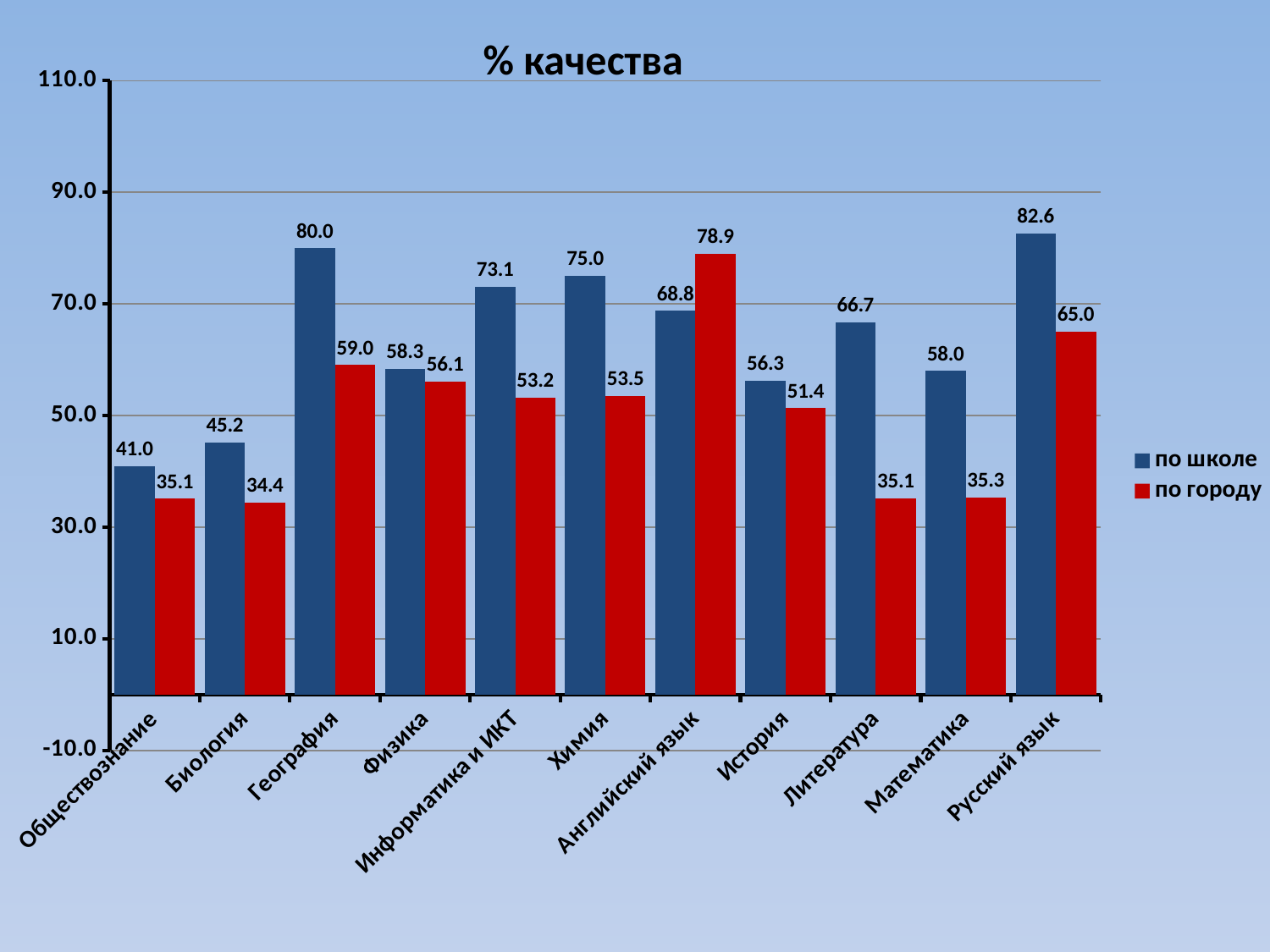
What is the difference between the по школе and по городу values for География? 21.0 What is the value for Литература in the по городу series? 35.1 What is the value for Информатика и ИКТ in the по школе series? 73.1 What is the title of the chart? % качества What kind of chart is shown on the slide? bar chart Which category has the highest value in the по школе series? Русский язык For Английский язык, which is larger: the по школе value or the по городу value? по городу What is the value for Английский язык in the по городу series? 78.9 Which category has the lowest value in the по городу series? Биология How many categories are shown on the x axis? 11 What is the value for Русский язык in the по школе series? 82.6 How many series does the legend list? 2